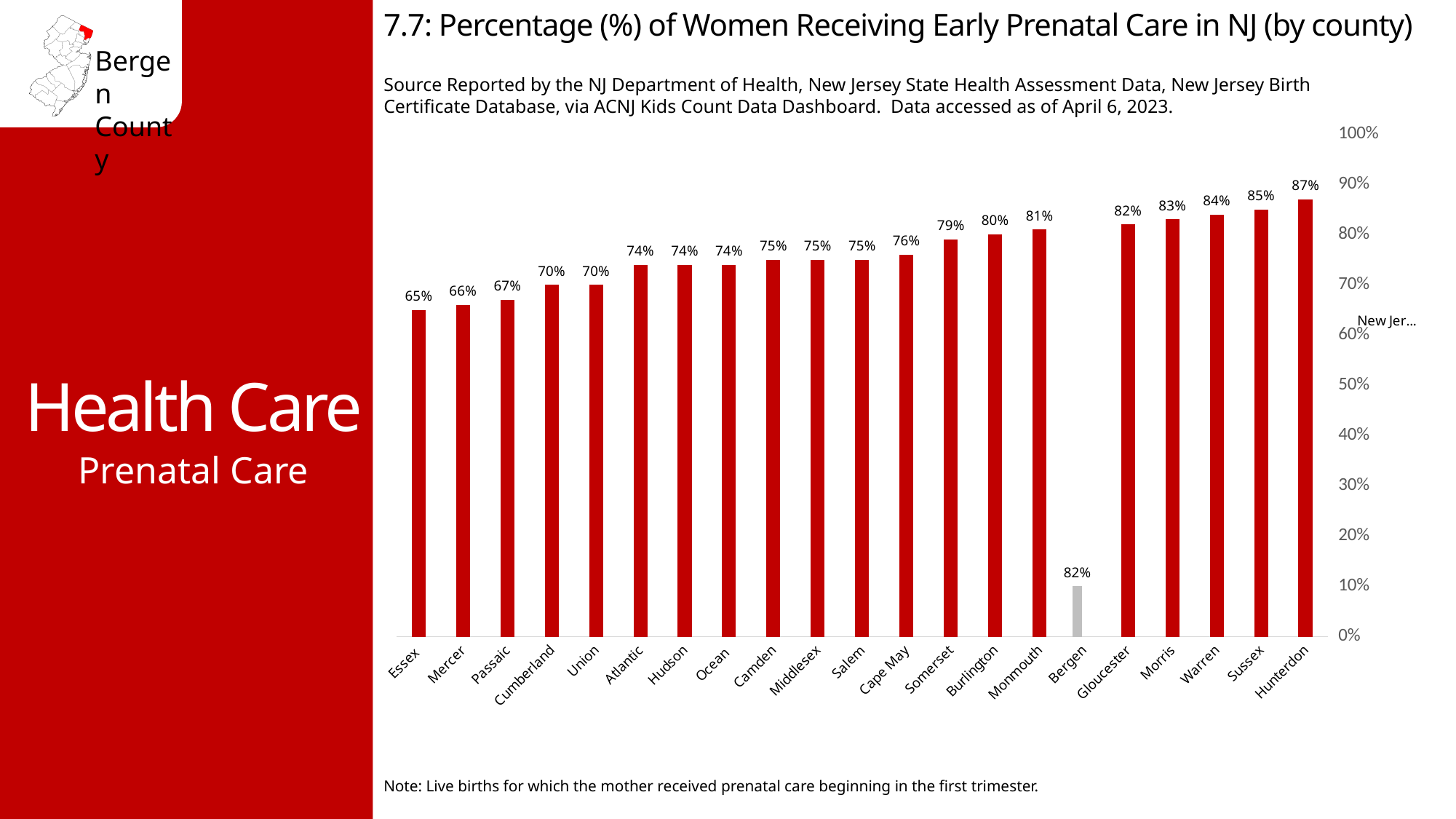
Which has a higher value, Morris or Camden? Morris How many counties are shown on the x axis of the chart? 21 Is the value for Monmouth greater or less than 70%? greater Do the values generally rise or fall from left to right along the x axis? Rise What is the difference between the values for Sussex and Cape May? 9 percentage points What percentage is shown for Somerset County? 79% What is the value shown for Hunterdon County? 87% What is the difference between the values for Hunterdon and Essex? 22 percentage points What percentage of women received early prenatal care in Essex County? 65% What kind of chart is used to show the percentage of women receiving early prenatal care? Bar chart Which county has the highest percentage of women receiving early prenatal care? Hunterdon What is the value for Cumberland County? 70%